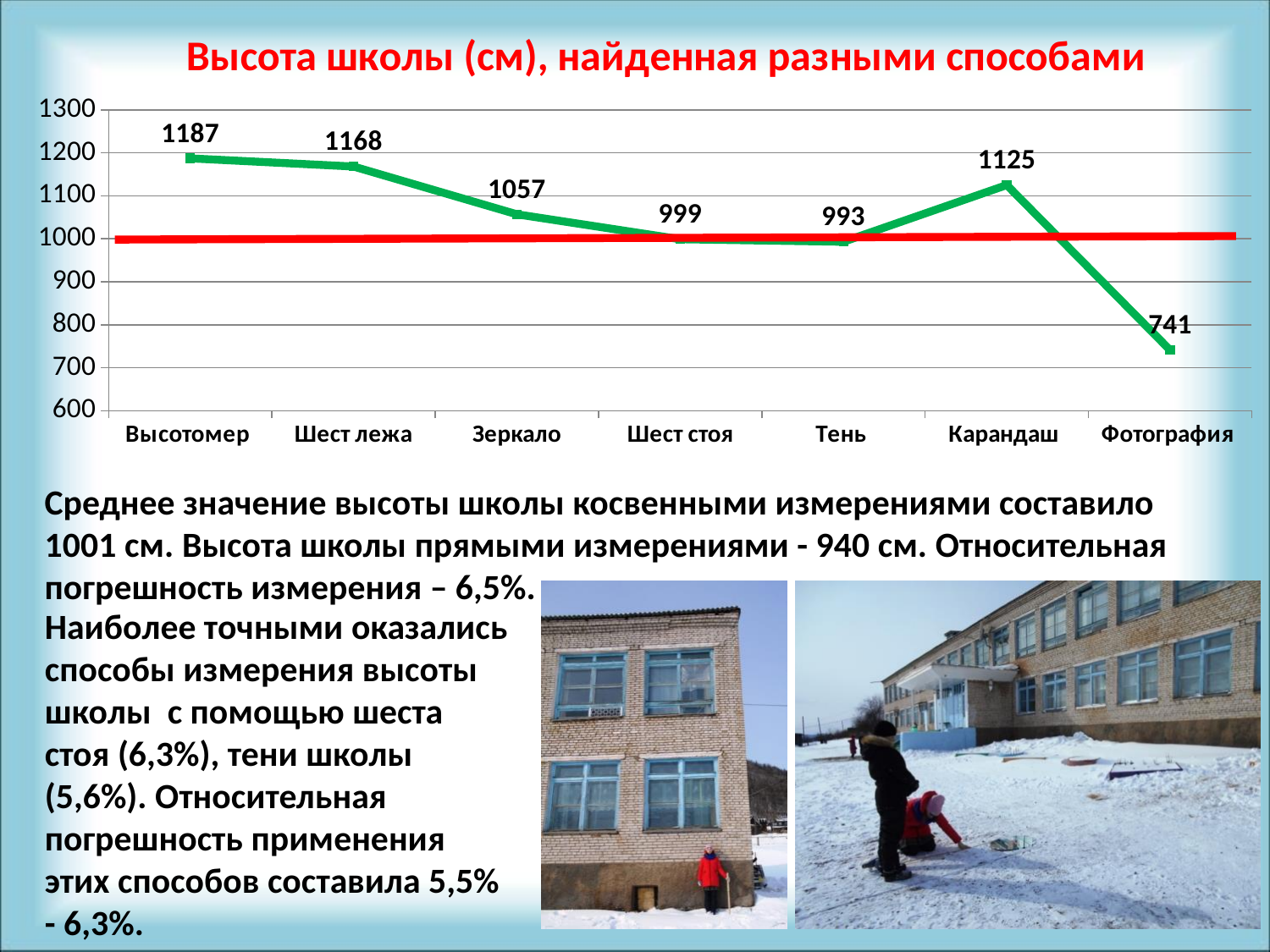
What is the difference between the values for Высотомер and Шест лежа? 19 Which category has the lowest value on the green line? Фотография What type of chart is shown on the slide? line chart Is the value for Карандаш greater or less than 1100? greater What is the value for Зеркало? 1057 What is the difference between the values for Карандаш and Фотография? 384 What is the title of the chart? Высота школы (см), найденная разными способами Which is larger, the value for Шест стоя or the value for Тень? Шест стоя Which category has the highest value on the green line? Высотомер What is the value for Высотомер? 1187 What is the value for Фотография? 741 How many categories are shown on the x axis? 7